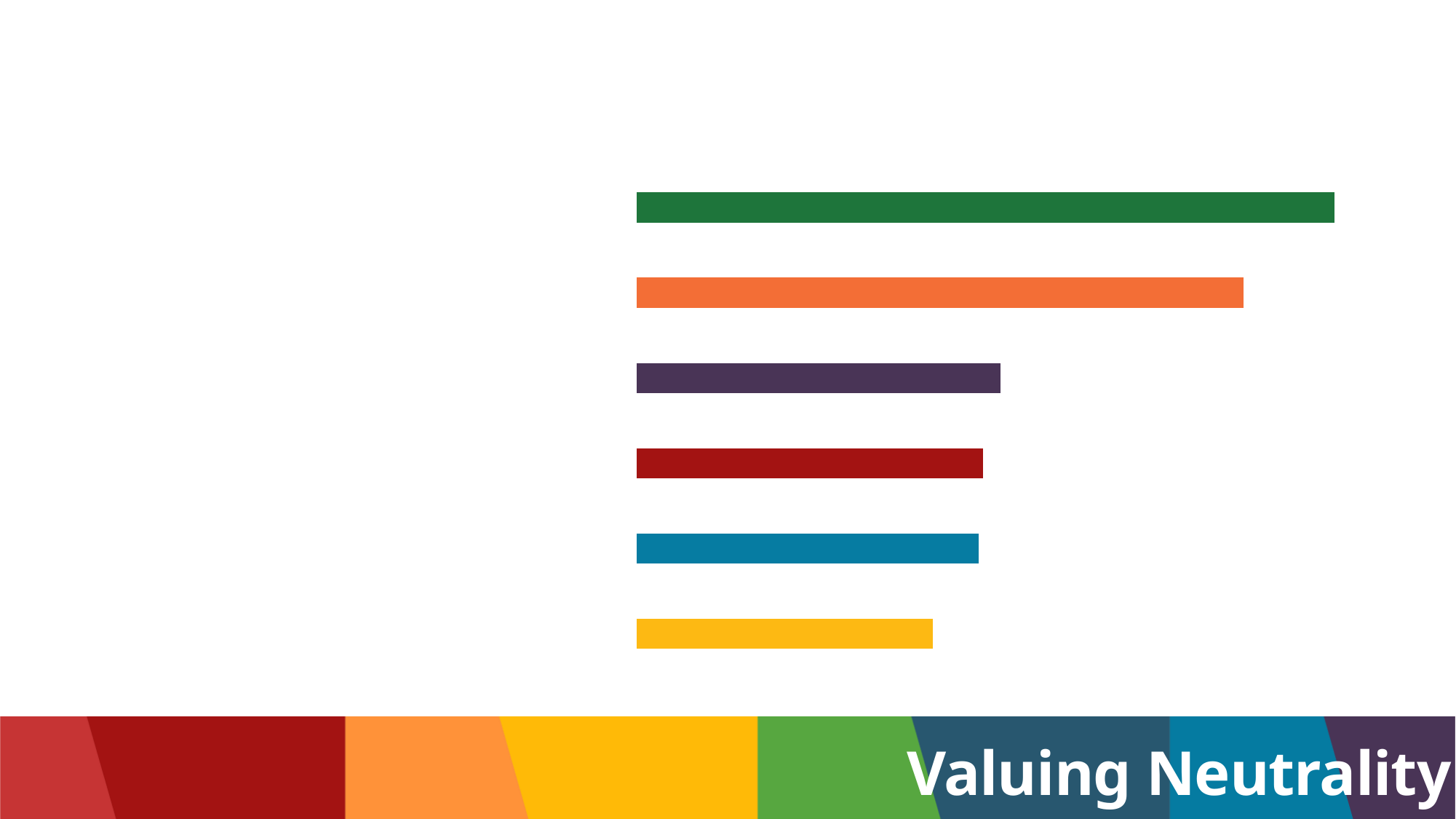
What kind of chart is shown on the slide? bar chart Do the bar lengths increase or decrease going from the top bar to the bottom bar? decrease What colour is the shortest bar in the chart? yellow How many bars does the chart contain? 6 What colour is the longest bar in the chart? green